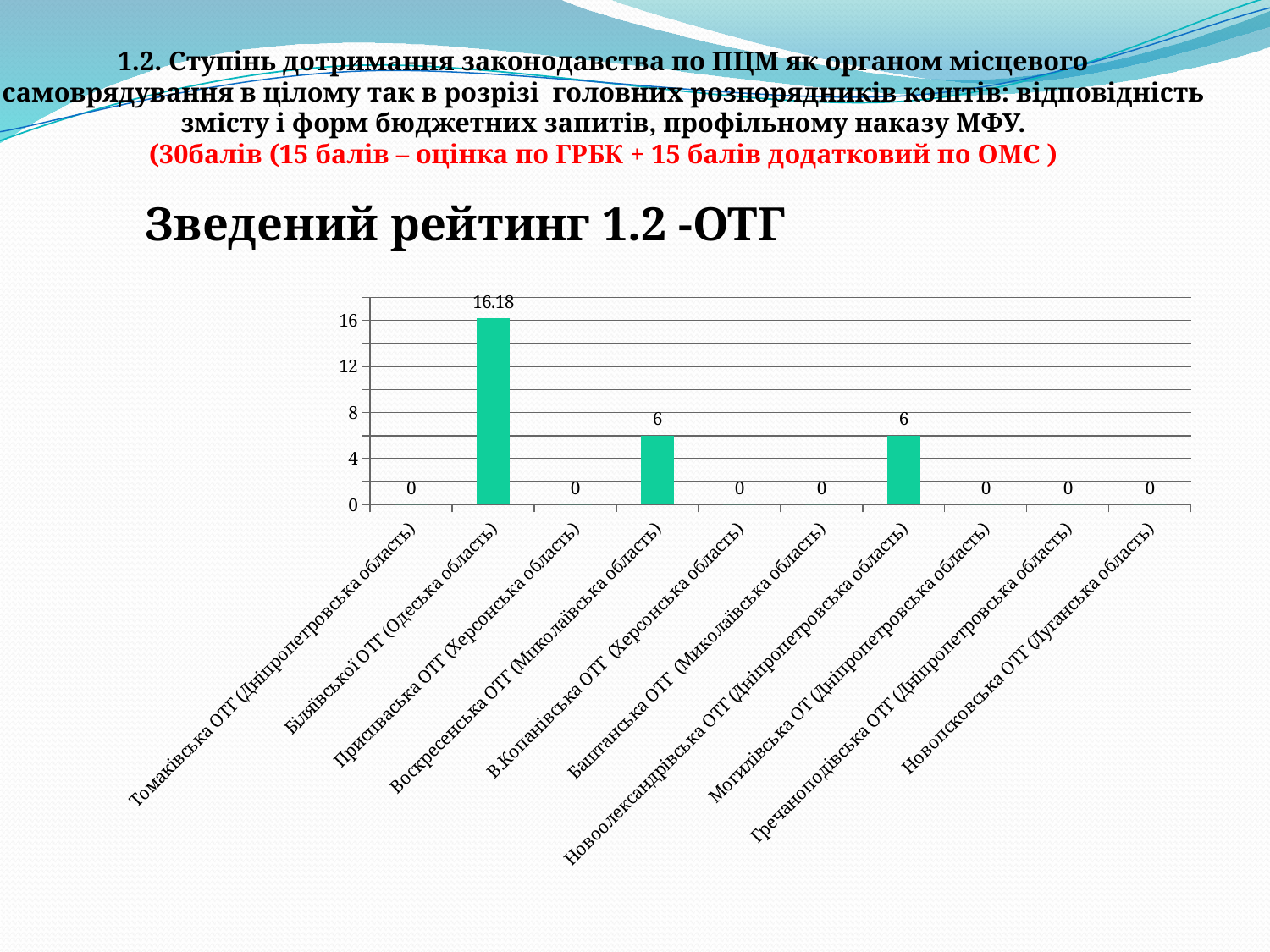
What is the title of the chart? Зведений рейтинг 1.2 -ОТГ Which is larger, the value for Біляївської ОТГ (Одеська область) or the value for Новоолександрівська ОТГ (Дніпропетровська область)? Біляївської ОТГ (Одеська область) How many categories have a value of 0? 7 What kind of chart is shown on the slide? bar chart Is the value for Біляївської ОТГ (Одеська область) greater or less than 12? greater What is the value for Біляївської ОТГ (Одеська область)? 16.18 How many categories are shown on the x axis? 10 What is the value for Новоолександрівська ОТГ (Дніпропетровська область)? 6 What is the difference between the values for Біляївської ОТГ (Одеська область) and Воскресенська ОТГ (Миколаївська область)? 10.18 What is the value for Томаківська ОТГ (Дніпропетровська область)? 0 What is the value for Воскресенська ОТГ (Миколаївська область)? 6 Which category has the highest value? Біляївської ОТГ (Одеська область)